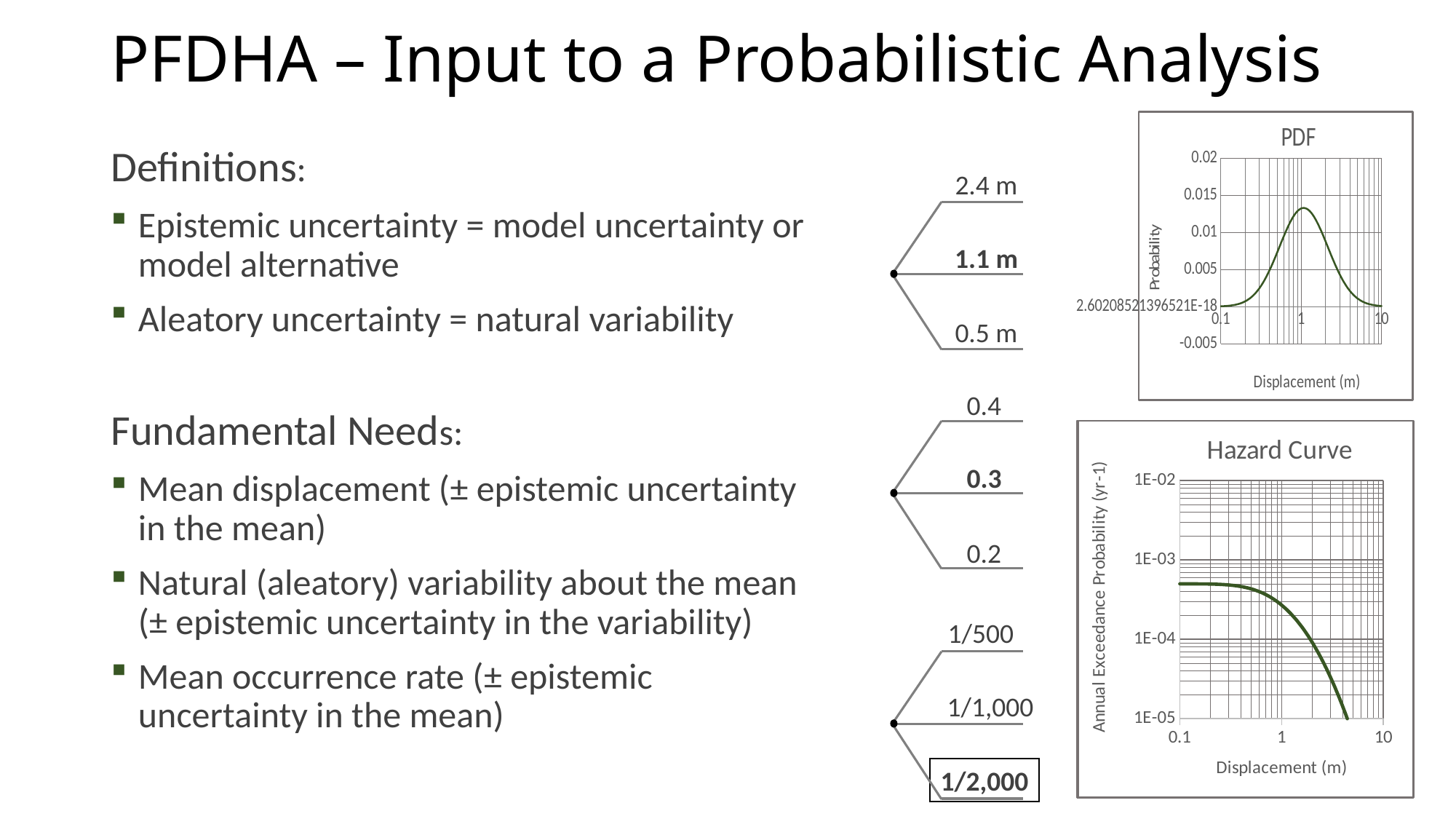
In the Hazard Curve chart, is the annual exceedance probability at a displacement of 1 m greater or less than 1E-04? greater In the PDF chart, is the peak probability greater or less than 0.01? greater How many charts are shown on the slide? 2 In the PDF chart, what is the label of the x axis? Displacement (m) In the Hazard Curve chart, is the annual exceedance probability at a displacement of 0.1 m greater or less than 1E-03? less In the Hazard Curve chart, do the values rise or fall as displacement increases from 1 m to 10 m? fall In the Hazard Curve chart, what is the label of the y axis? Annual Exceedance Probability (yr-1) What kind of chart is the Hazard Curve chart? line chart What kind of chart is the PDF chart? line chart In the PDF chart, does the probability rise or fall as displacement increases from 0.1 m to 1 m? rise